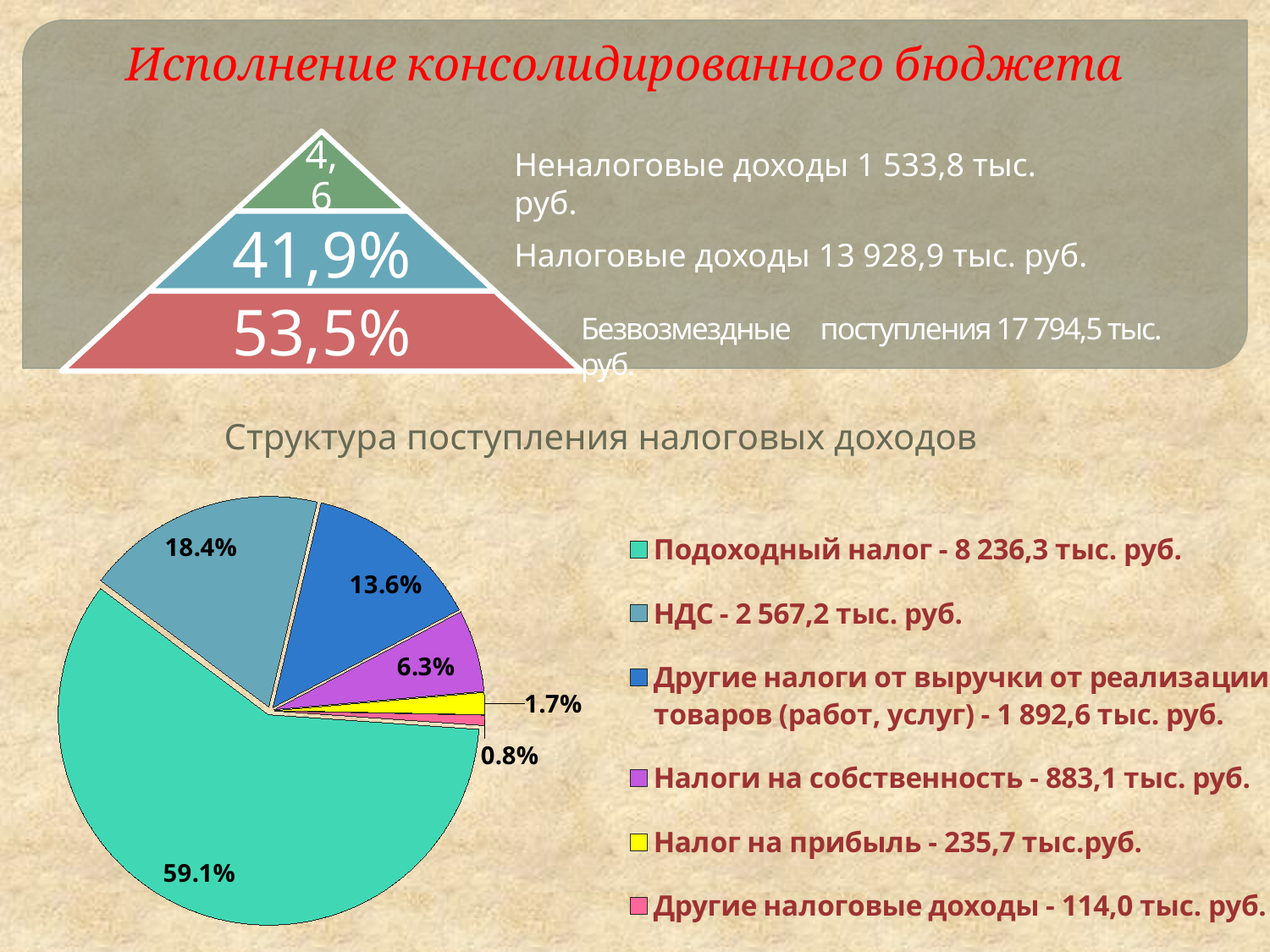
In the pie chart "Структура поступления налоговых доходов", which is larger: the share for НДС or the share for Другие налоги от выручки от реализации товаров (работ, услуг)? НДС In the pie chart "Структура поступления налоговых доходов", what share is shown for Налоги на собственность? 6.3% In the pie chart "Структура поступления налоговых доходов", how many slices does the pie have? 6 What kind of chart is shown under the heading "Структура поступления налоговых доходов"? pie chart In the pie chart "Структура поступления налоговых доходов", what share is shown for Налог на прибыль? 1.7% In the pie chart "Структура поступления налоговых доходов", what is the difference in percentage points between the share for НДС and the share for Налоги на собственность? 12.1% In the pie chart "Структура поступления налоговых доходов", which category has the smallest slice? Другие налоговые доходы In the pie chart "Структура поступления налоговых доходов", what share is shown for Другие налоговые доходы? 0.8% In the pie chart "Структура поступления налоговых доходов", which category has the largest slice? Подоходный налог In the pie chart "Структура поступления налоговых доходов", what amount does the legend give for НДС? 2 567,2 тыс. руб.